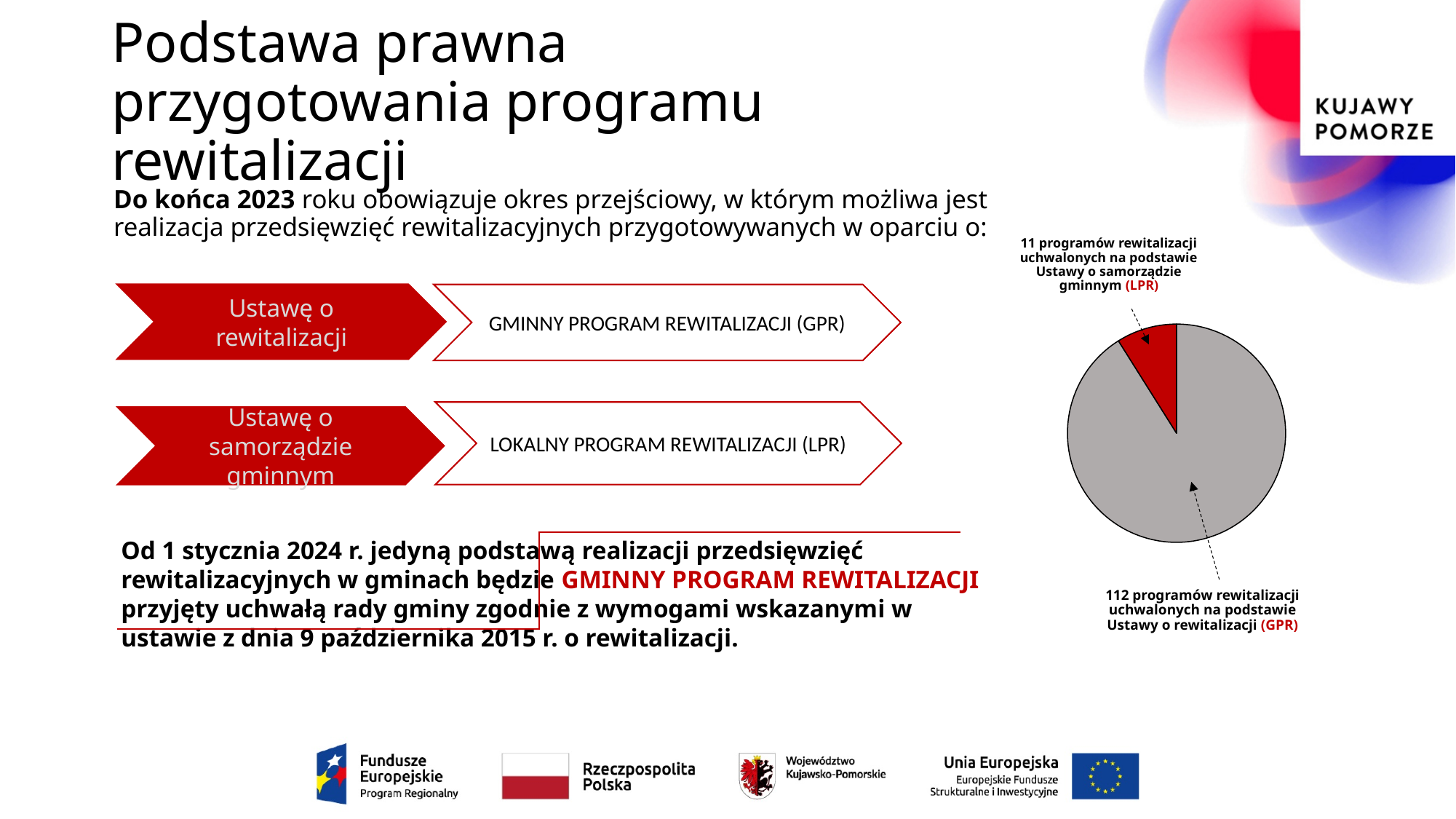
What is the difference between the number of GPR programs and the number of LPR programs shown in the pie chart? 101 Which category in the pie chart has the larger number of programs, LPR or GPR? GPR What type of chart is shown on the right side of the slide? pie chart How many revitalization programs were adopted on the basis of the Revitalization Act (GPR) according to the pie chart? 112 Is the number of LPR programs larger or smaller than the number of GPR programs in the pie chart? smaller What is the total number of revitalization programs represented in the pie chart? 123 How many slices does the pie chart have? 2 What colour is the slice representing the GPR programs in the pie chart? grey How many revitalization programs were adopted on the basis of the Act on Municipal Self-Government (LPR) according to the pie chart? 11 What colour is the slice representing the LPR programs in the pie chart? red Which category in the pie chart has the smaller number of programs? LPR